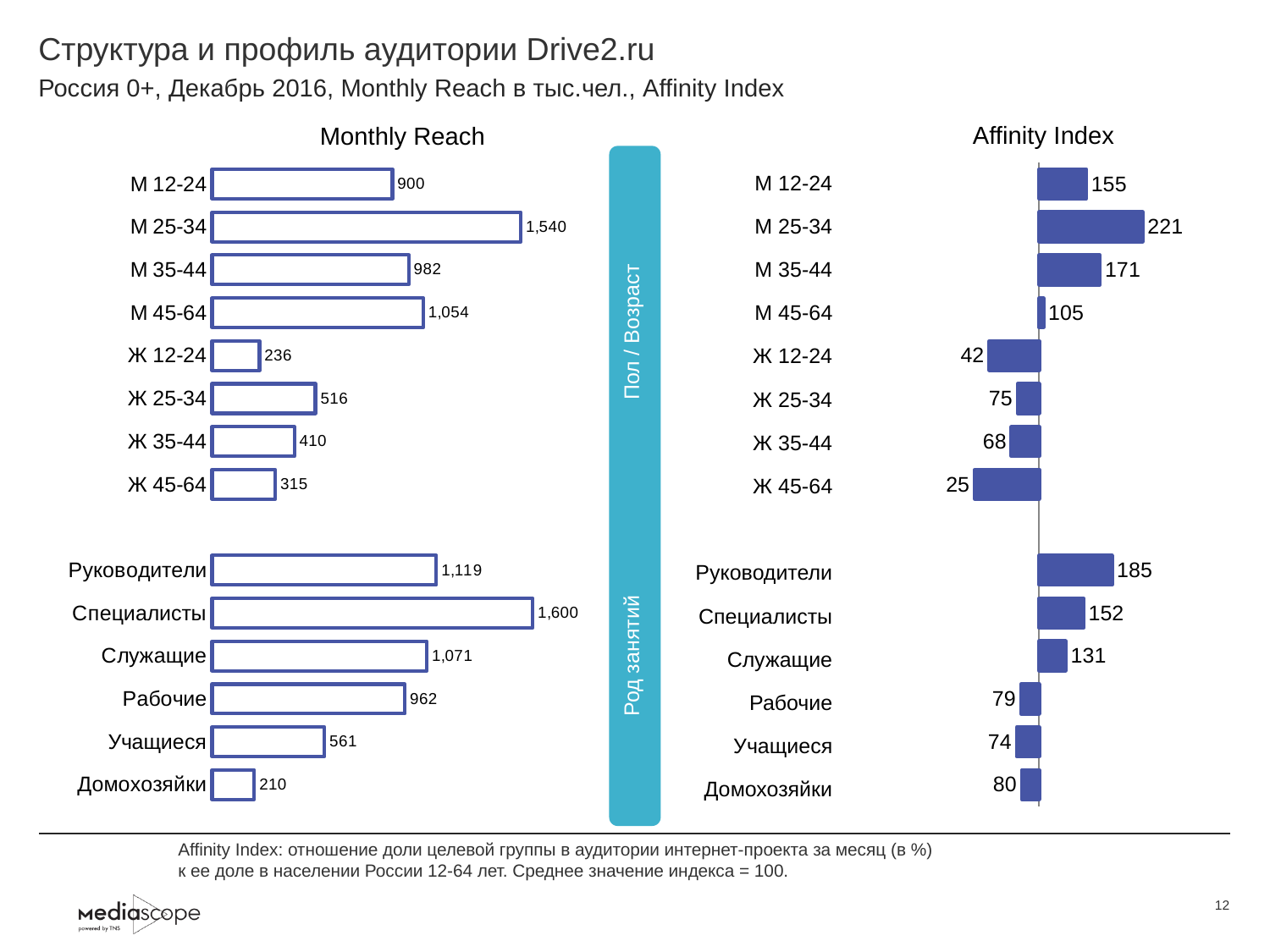
In the Monthly Reach chart, which category has the highest value? Специалисты In the Monthly Reach chart, what is the value for Домохозяйки? 210 In the Affinity Index chart, which is larger: Ж 25-34 or Ж 35-44? Ж 25-34 In the Monthly Reach chart, what is the difference between М 25-34 and М 12-24? 640 How many categories are shown in the Monthly Reach chart? 14 In the Monthly Reach chart, what is the value for М 25-34? 1,540 In the Affinity Index chart, which category has the lowest value? Ж 45-64 What kind of chart is the Affinity Index chart? Bar chart In the Affinity Index chart, which category has the highest value? М 25-34 In the Monthly Reach chart, which is larger: Служащие or Рабочие? Служащие In the Affinity Index chart, what is the difference between М 25-34 and М 45-64? 116 In the Affinity Index chart, what is the value for Руководители? 185